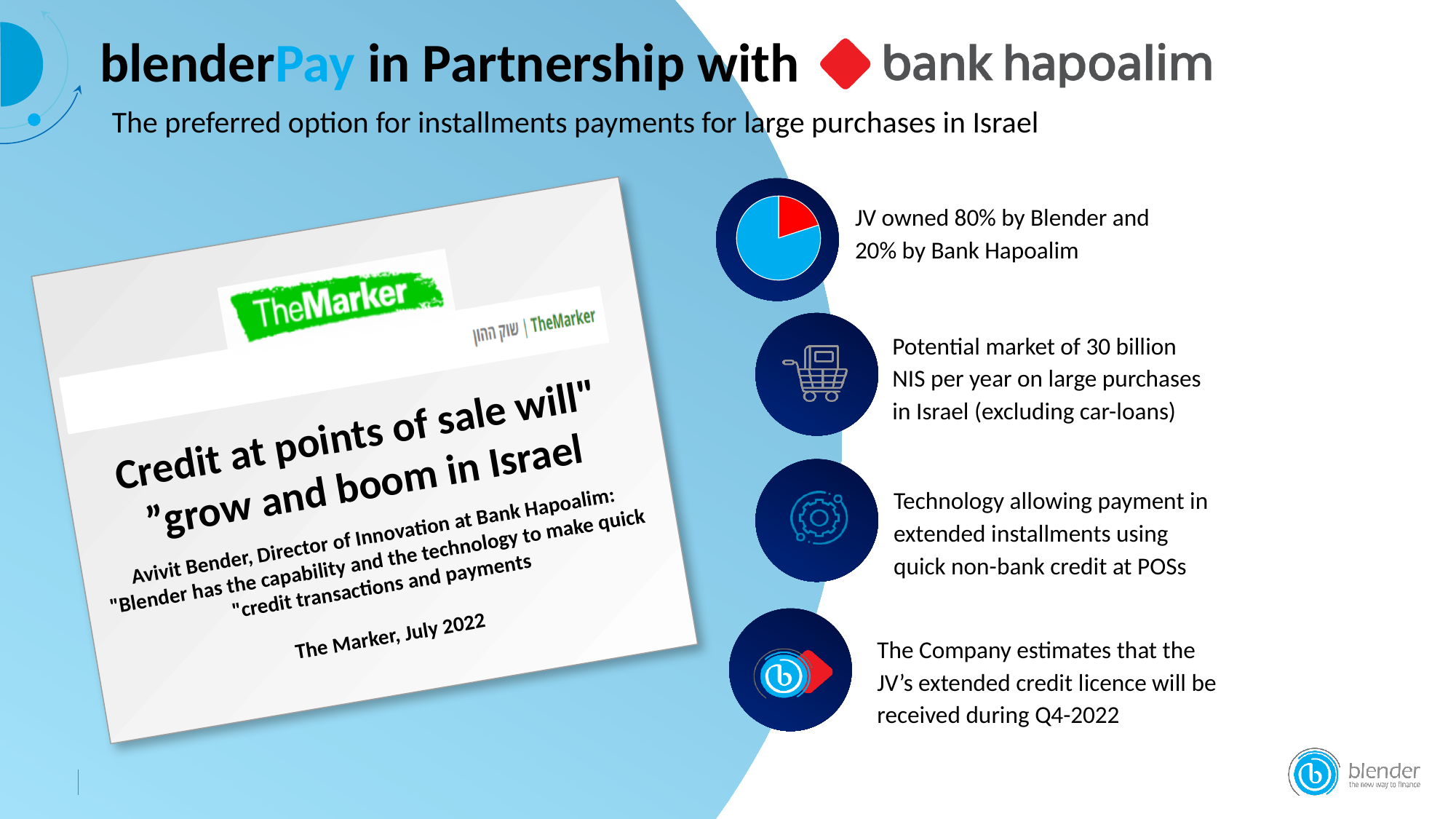
In the JV ownership pie chart, is Blender's share larger or smaller than Bank Hapoalim's share? larger According to the pie chart and its caption, what share of the JV is owned by Bank Hapoalim? 20% What colour is the larger slice of the JV ownership pie chart? blue What kind of chart is shown next to the text about JV ownership? pie chart In the JV ownership pie chart, which owner holds the larger share? Blender How many slices does the JV ownership pie chart have? 2 According to the pie chart and its caption, what share of the JV is owned by Blender? 80% In the JV ownership pie chart, which owner holds the smaller share? Bank Hapoalim What is the difference in percentage points between Blender's share and Bank Hapoalim's share of the JV? 60 What colour is the smaller slice of the JV ownership pie chart? red